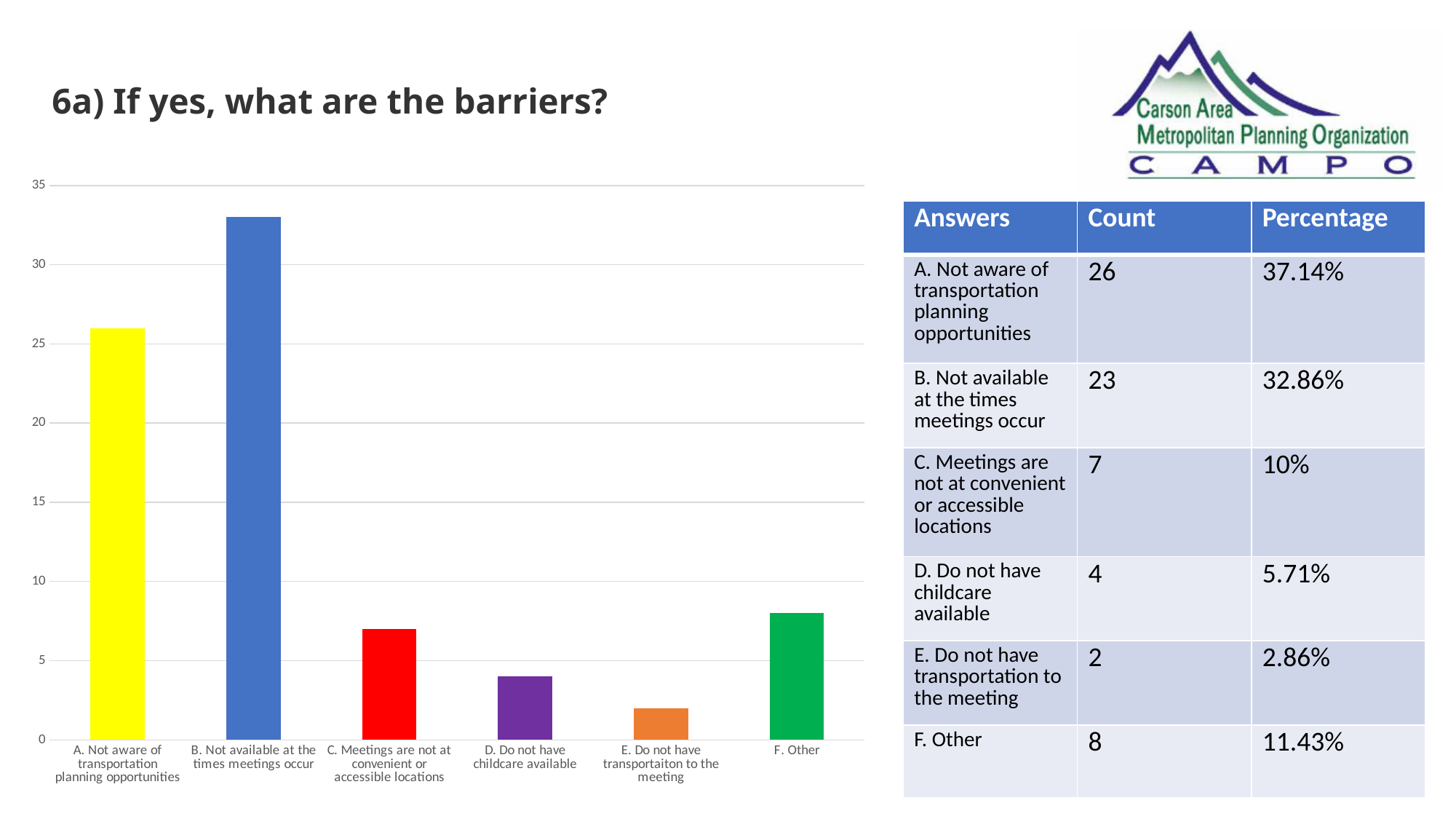
Which category has the shortest bar in the chart? E. Do not have transportaiton to the meeting Is the value for 'B. Not available at the times meetings occur' greater or less than 30? greater Which is larger: the value for 'A. Not aware of transportation planning opportunities' or the value for 'F. Other'? A. Not aware of transportation planning opportunities What is the count for 'D. Do not have childcare available'? 4 What is the count for 'A. Not aware of transportation planning opportunities'? 26 What is the count for 'C. Meetings are not at convenient or accessible locations'? 7 What colour is the bar for 'F. Other'? green What type of chart is shown on the slide? bar chart Which category has the tallest bar in the chart? B. Not available at the times meetings occur How many categories (answer options) are plotted in the chart? 6 What is the difference between the counts for 'A. Not aware of transportation planning opportunities' and 'C. Meetings are not at convenient or accessible locations'? 19 What is the count for 'F. Other'? 8